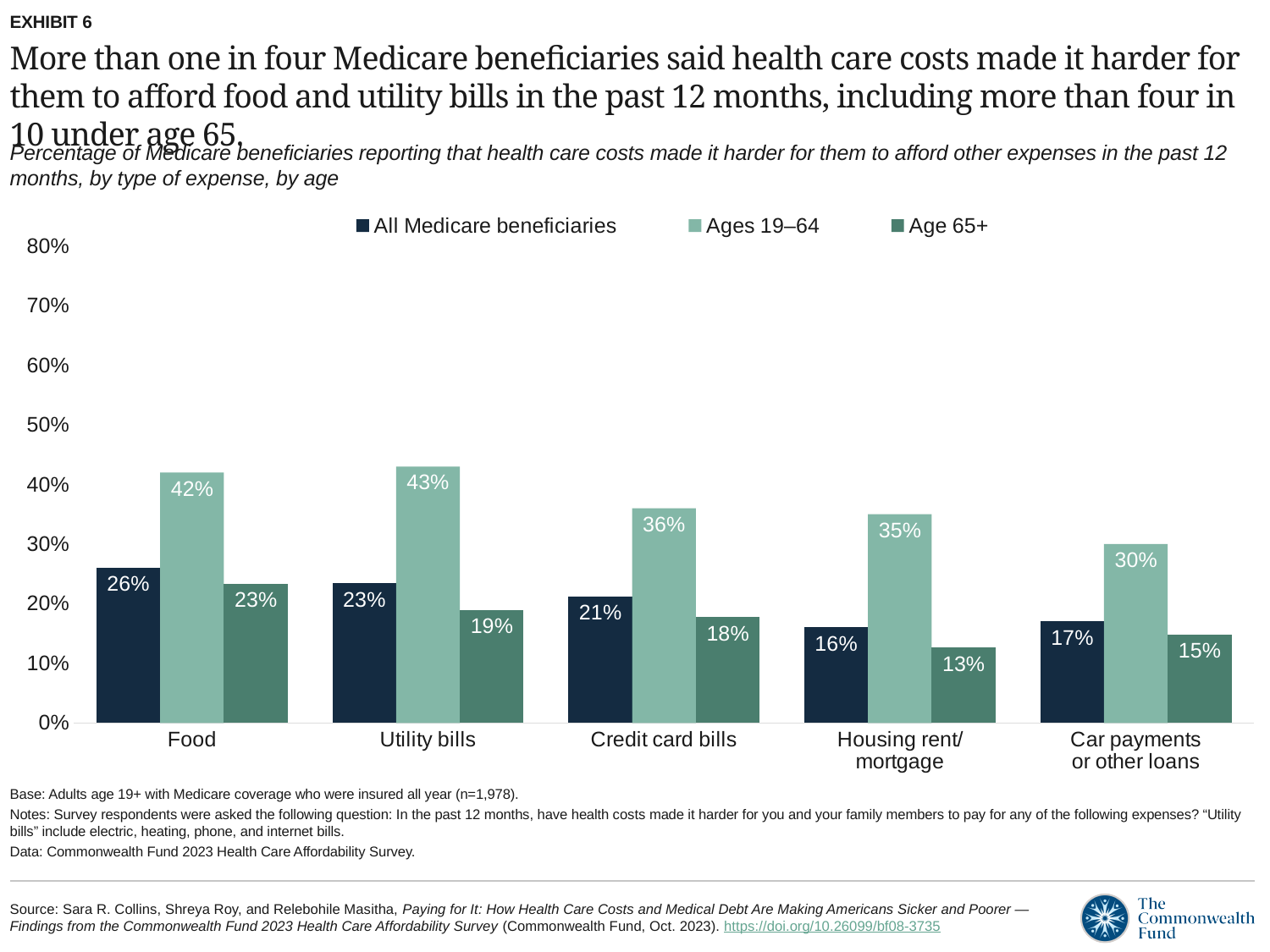
What kind of chart is shown on the slide? Bar chart How many expense categories are shown on the x axis? 5 What percentage of all Medicare beneficiaries said health care costs made it harder to afford food? 26% Which expense category has the lowest value for all Medicare beneficiaries? Housing rent/mortgage Is the value for Ages 19–64 for housing rent/mortgage greater or less than 30%? greater What is the value for Ages 19–64 for utility bills? 43% What is the difference between the Ages 19–64 and Age 65+ values for credit card bills? 18 percentage points How many series does the legend list? 3 What is the value for Age 65+ for housing rent/mortgage? 13% Which expense category has the highest value for Ages 19–64? Utility bills Which series is shown in the darkest navy colour? All Medicare beneficiaries Which is larger: the Age 65+ value for food or the Age 65+ value for car payments or other loans? Food